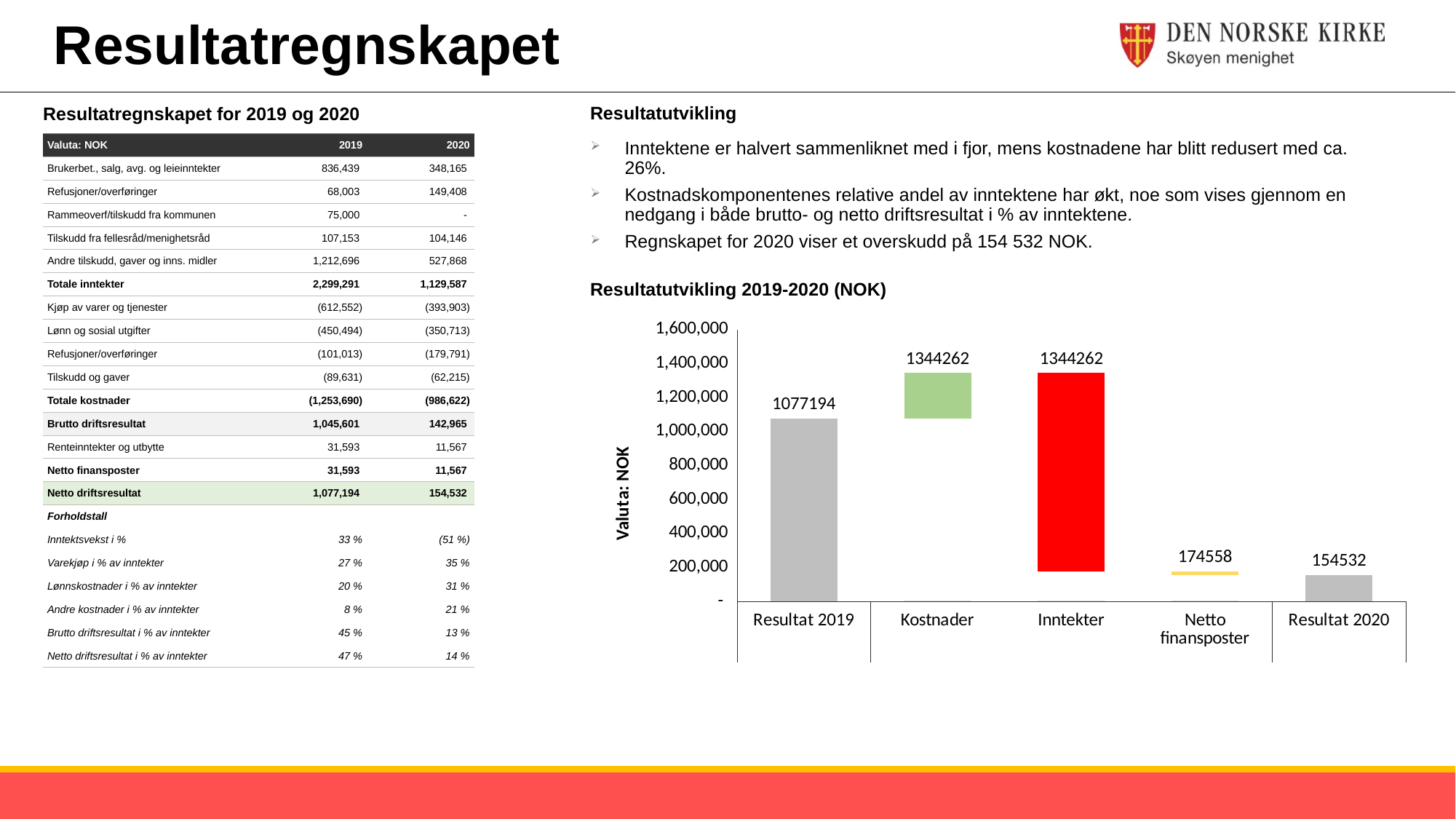
What is the value shown for Resultat 2019 in the Resultatutvikling 2019-2020 (NOK) chart? 1077194 Which category has the lowest value in the Resultatutvikling 2019-2020 (NOK) chart? Resultat 2020 What is the value shown for Resultat 2020 in the chart? 154532 What is the title of the vertical axis in the chart? Valuta: NOK Is the value for Resultat 2019 in the chart greater or less than 1,000,000? greater What is the difference between the Netto finansposter value and the Resultat 2020 value in the chart? 20026 What kind of chart is the Resultatutvikling 2019-2020 (NOK) chart? bar chart How many categories are shown on the x axis of the Resultatutvikling 2019-2020 (NOK) chart? 5 What is the difference between the Resultat 2019 value and the Resultat 2020 value in the chart? 922662 In the chart, which is larger: the value for Resultat 2019 or the value for Kostnader? Kostnader What is the value shown for Netto finansposter in the chart? 174558 What value is labelled on the Kostnader bar in the chart? 1344262